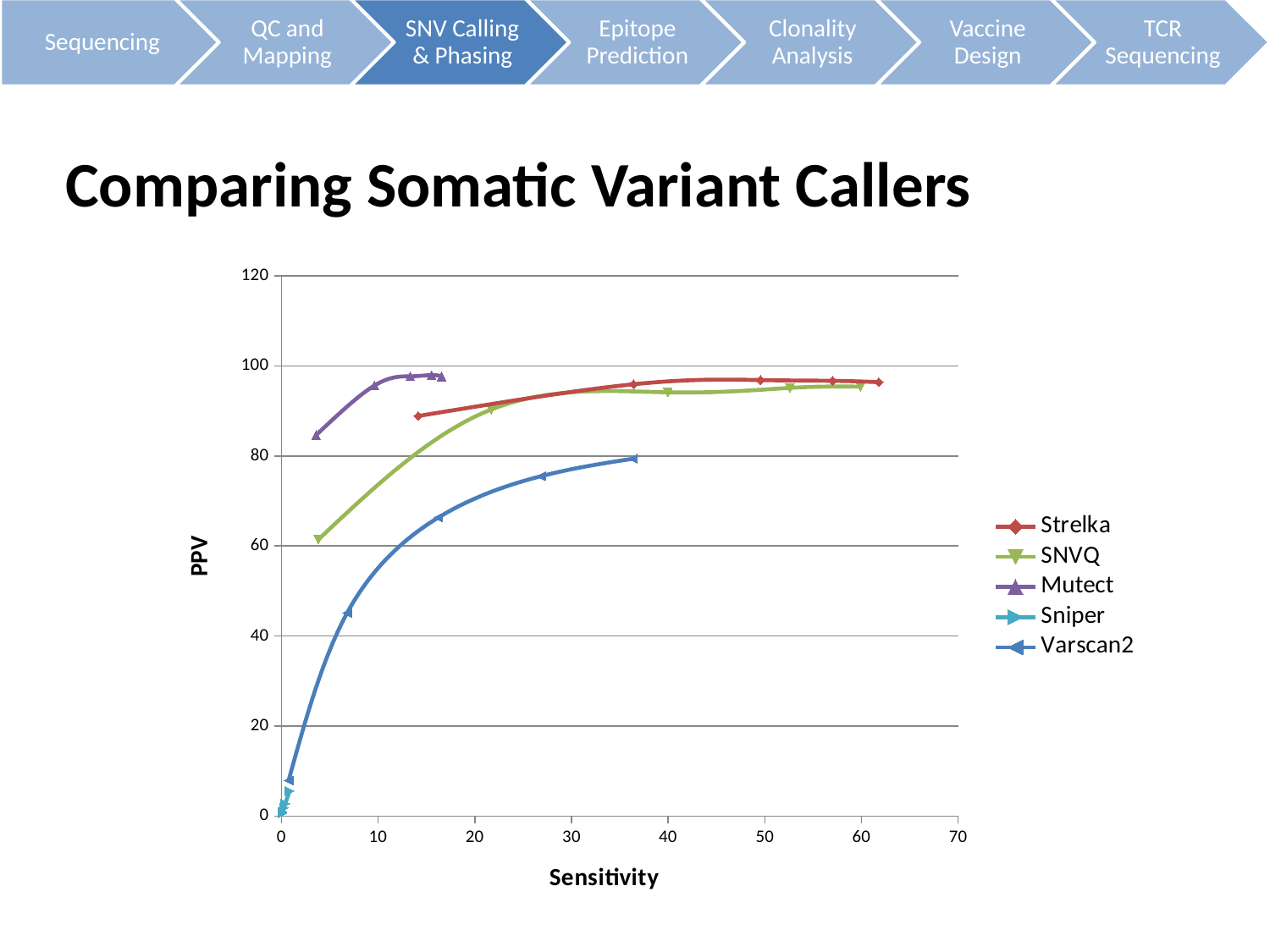
Are all the PPV values for Sniper greater or less than 20? less Is the highest PPV value reached by Varscan2 greater or less than 100? less What is the title of the chart on the slide? Comparing Somatic Variant Callers Is the highest sensitivity reached by Mutect greater or less than 20? less How many series does the legend list? 5 Which series has the lowest PPV values on the chart? Sniper Which series reaches the highest sensitivity on the chart? Strelka What are the x-axis and y-axis titles of the chart? Sensitivity and PPV What kind of chart is shown on the slide? line chart Does the PPV for Varscan2 rise or fall as sensitivity increases? rise